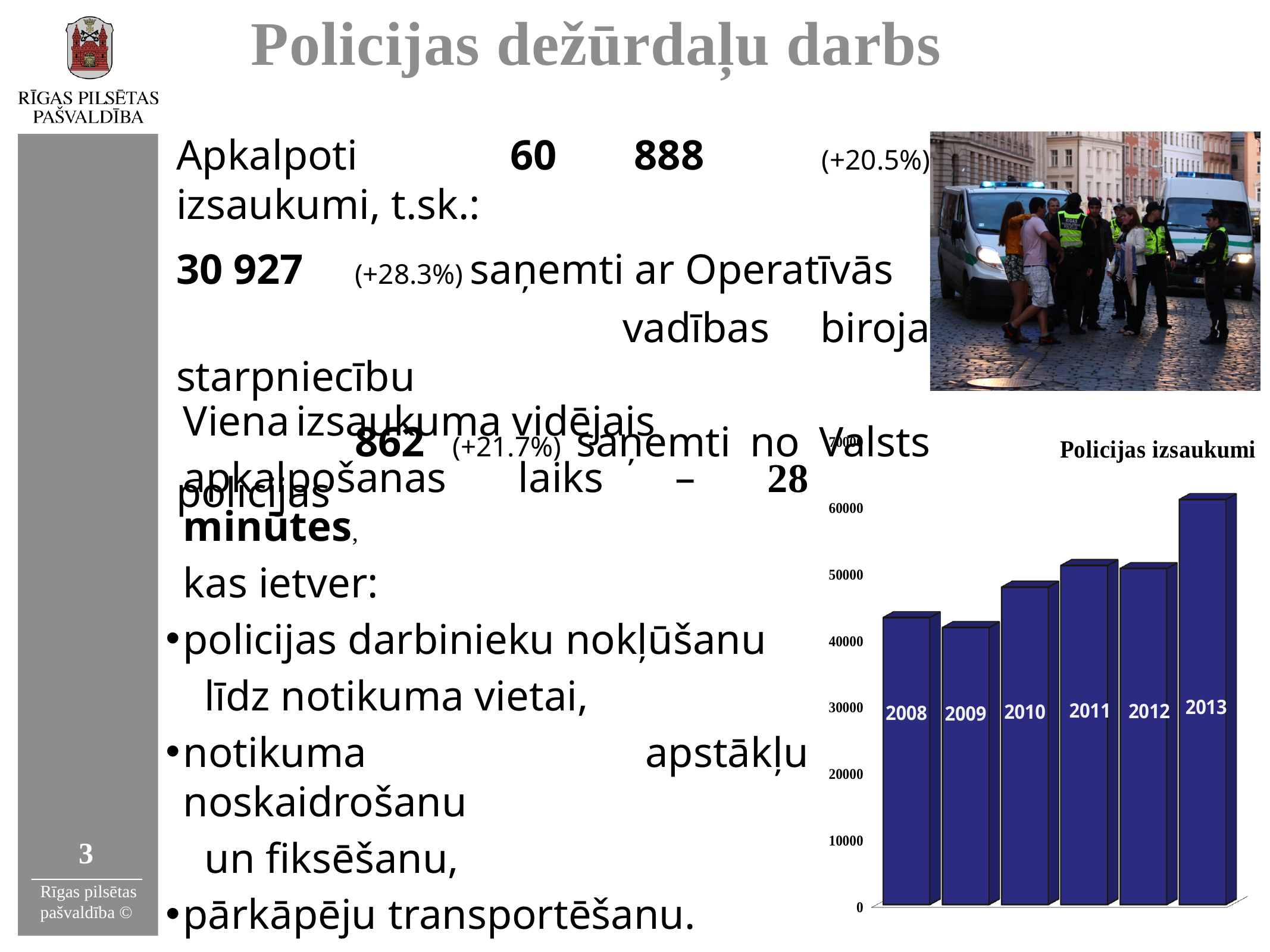
In the Policijas izsaukumi chart, is the value for 2008 greater or less than 50000? less In the Policijas izsaukumi chart, is the value for 2009 greater or less than 40000? greater Which year has the highest value in the Policijas izsaukumi chart? 2013 Do the values in the Policijas izsaukumi chart generally rise or fall from 2008 to 2013? rise How many years are shown in the Policijas izsaukumi chart? 6 In the Policijas izsaukumi chart, which is larger, the value for 2010 or the value for 2013? 2013 In the Policijas izsaukumi chart, is the value for 2010 greater or less than 50000? less In the Policijas izsaukumi chart, which is larger, the value for 2008 or the value for 2011? 2011 What is the title of the chart on the slide? Policijas izsaukumi What kind of chart is shown on the slide? bar chart